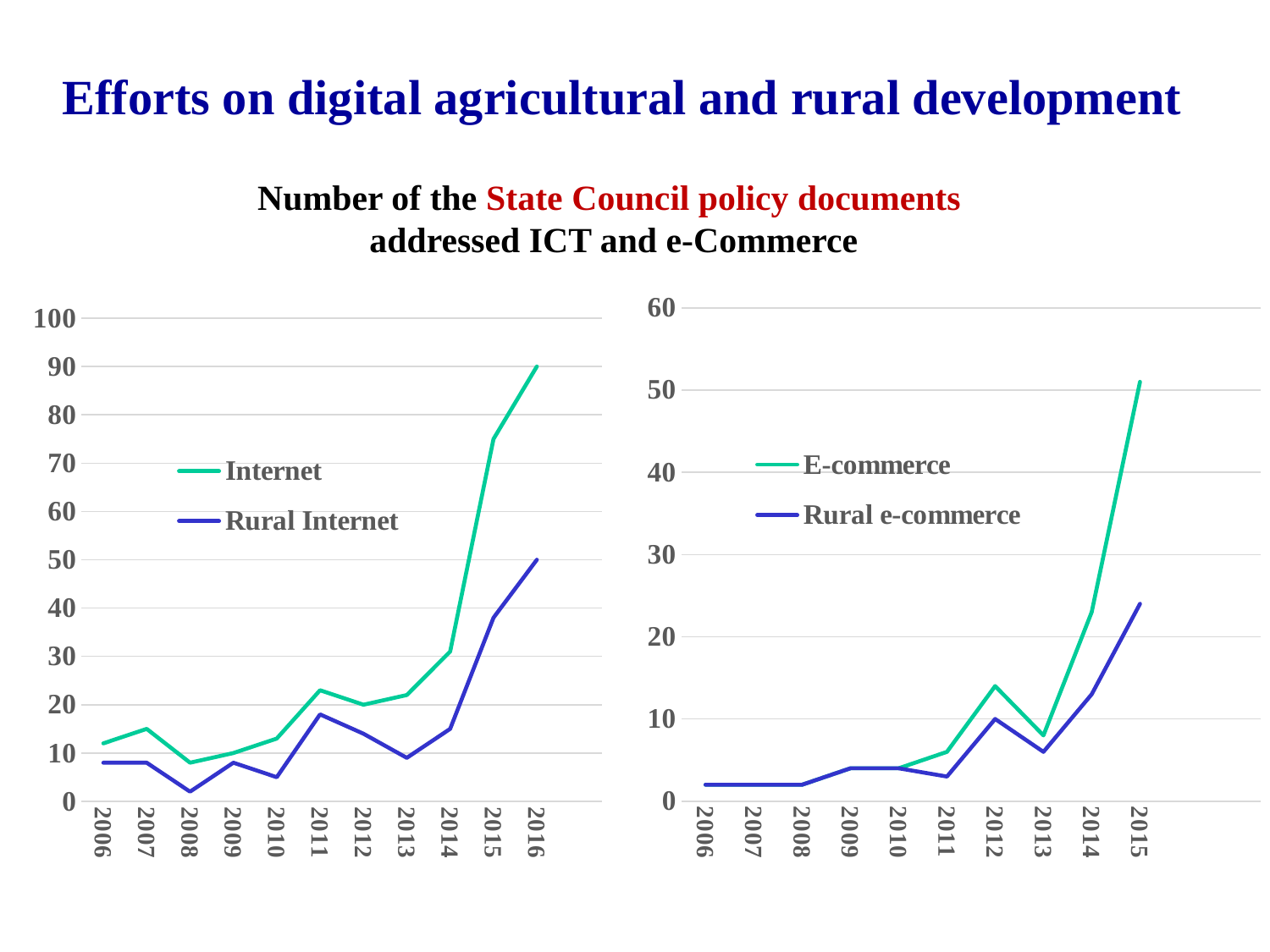
In the right chart, how many years are shown on the x axis? 10 In the left chart, in which year is the Internet series highest? 2016 In the right chart, is the value for E-commerce in 2015 greater or less than 40? greater In the left chart, how many years are shown on the x axis? 11 In the left chart, how many series does the legend list? 2 In the right chart, does the E-commerce series rise or fall from 2013 to 2015? rise In the left chart, in 2015, which is larger: Internet or Rural Internet? Internet What kind of chart is the left chart showing Internet and Rural Internet? line chart In the right chart, what are the two series named in the legend? E-commerce and Rural e-commerce In the left chart, in which year is the Rural Internet series lowest? 2008 In the left chart, is the value for Rural Internet in 2008 greater or less than 10? less In the left chart, is the value for Internet in 2016 greater or less than 80? greater